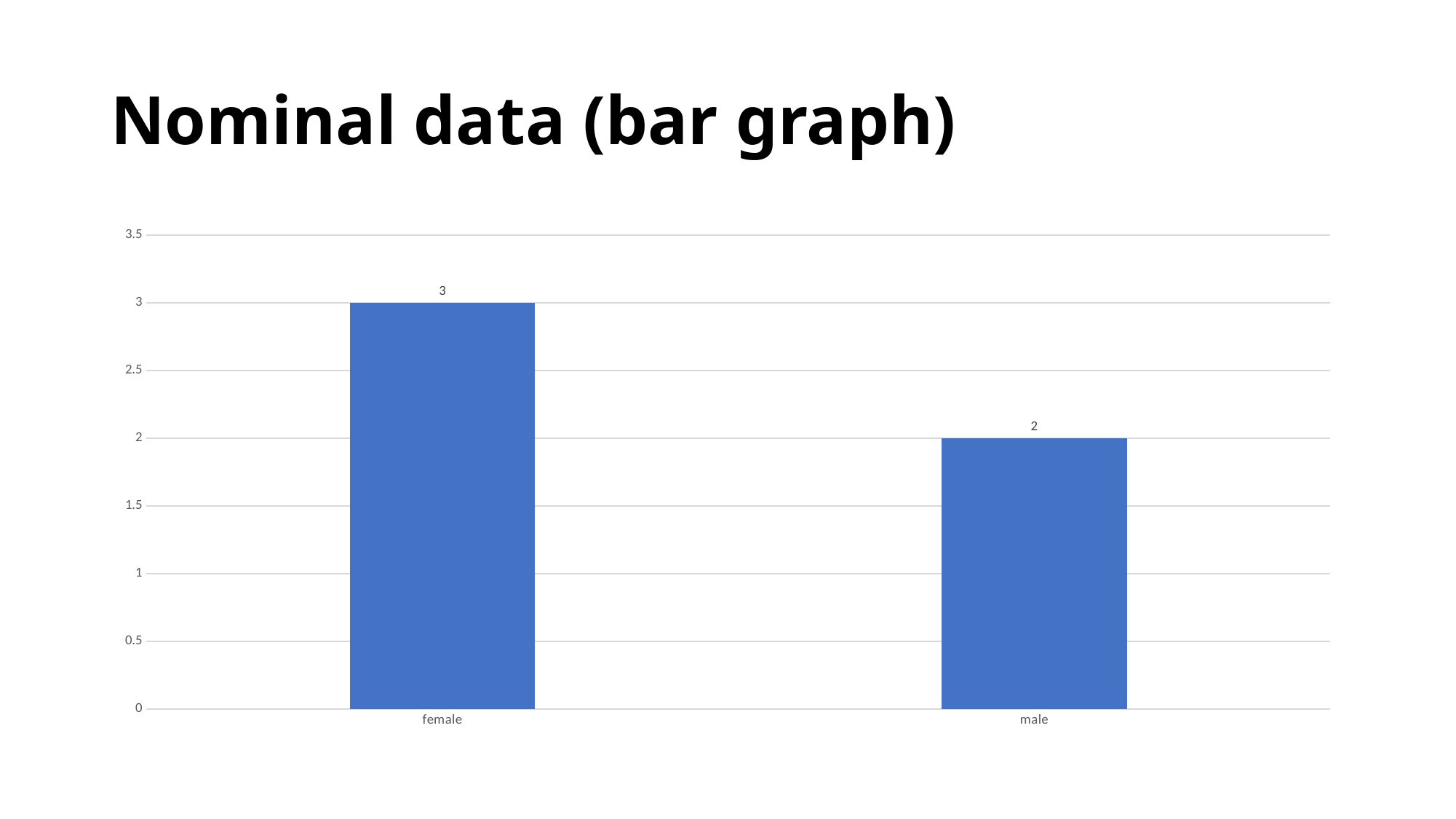
What is the difference between the values for female and male? 1 What is the highest value shown on the y axis? 3.5 How many categories are shown on the x axis? 2 What is the value for male? 2 Which is larger, the value for female or the value for male? female Which category has the lowest value? male Is the value for female greater or less than 2.5? greater What is the title of the slide? Nominal data (bar graph) What is the value for female? 3 Which category has the highest value? female What kind of chart is shown on the slide? bar chart Is the value for male greater or less than 2.5? less